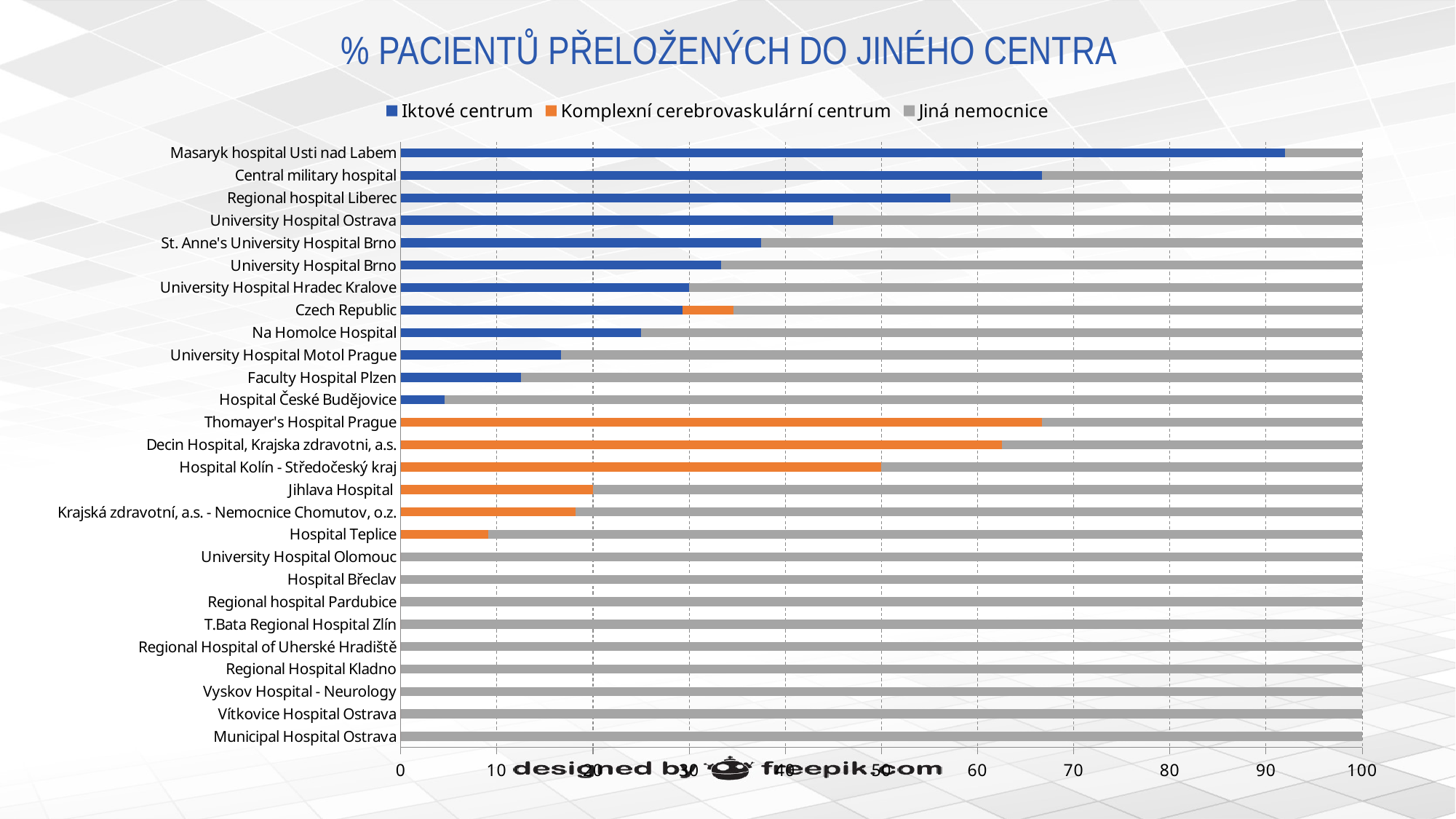
Is the Iktové centrum value for Masaryk hospital Usti nad Labem greater or less than 80? greater Is the Iktové centrum value for Hospital České Budějovice greater or less than 10? less Is the Komplexní cerebrovaskulární centrum value for Decin Hospital, Krajska zdravotni, a.s. greater or less than 60? greater What is the title of the chart? % PACIENTŮ PŘELOŽENÝCH DO JINÉHO CENTRA What is the total of the stacked bar for Municipal Hospital Ostrava? 100 Which has the larger Iktové centrum value: Central military hospital or Regional hospital Liberec? Central military hospital What kind of chart is shown on the slide? Stacked bar chart How many series does the legend list? 3 Which hospital has the largest Komplexní cerebrovaskulární centrum share? Thomayer's Hospital Prague Which hospital has the largest Iktové centrum share? Masaryk hospital Usti nad Labem How many hospitals (categories) are plotted on the chart? 27